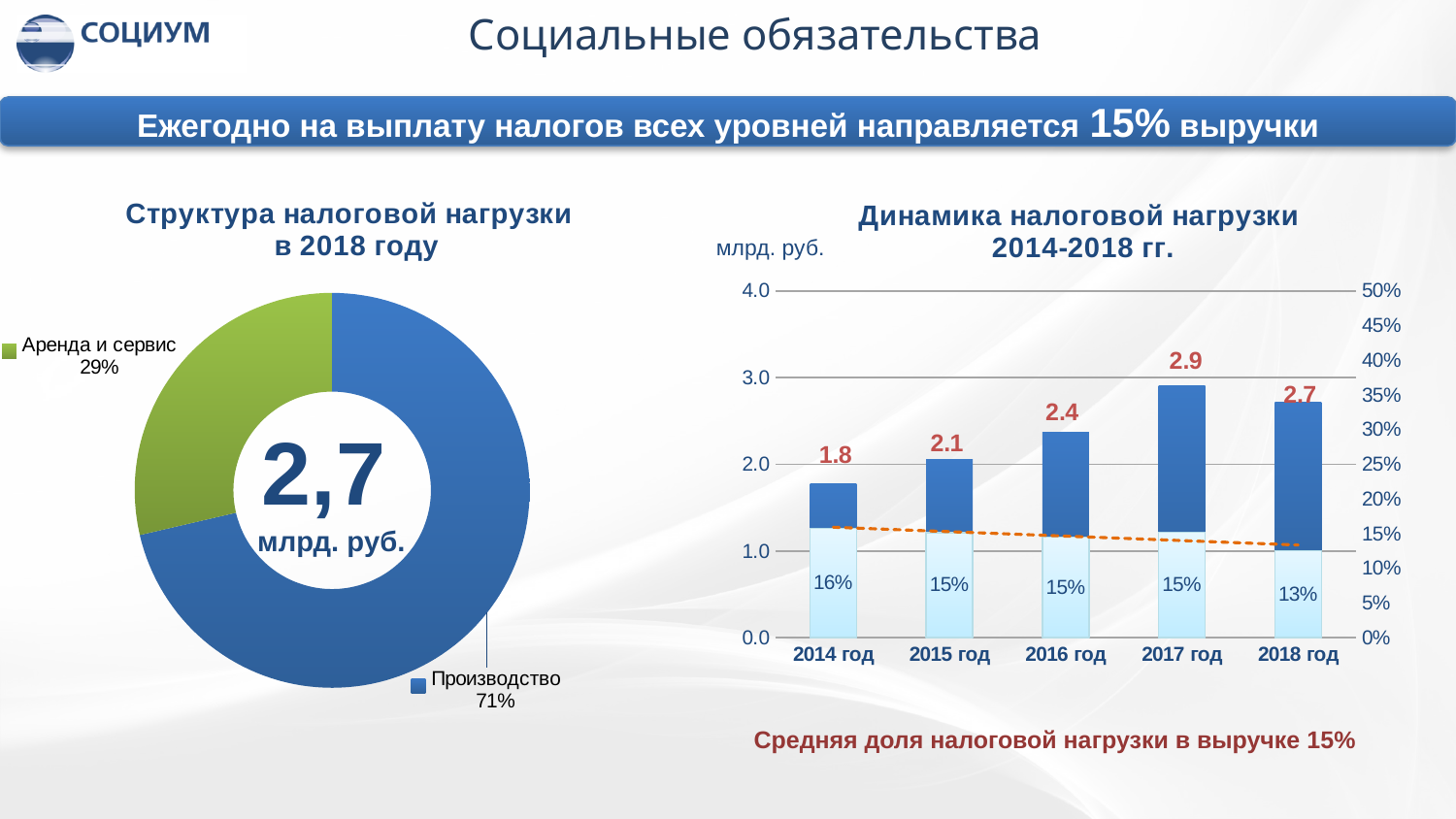
In the chart 'Динамика налоговой нагрузки 2014-2018 гг.', what is the value for 2016 год? 2.4 What kind of chart is 'Структура налоговой нагрузки в 2018 году'? Donut (pie) chart In the chart 'Структура налоговой нагрузки в 2018 году', what share does 'Производство' have? 71% In the chart 'Динамика налоговой нагрузки 2014-2018 гг.', what is the difference between the values for 2017 год and 2018 год? 0.2 In the chart 'Структура налоговой нагрузки в 2018 году', which category has the larger share? Производство In the chart 'Динамика налоговой нагрузки 2014-2018 гг.', what percentage is shown for 2018 год? 13% How many years are shown on the x axis of the chart 'Динамика налоговой нагрузки 2014-2018 гг.'? 5 What value is printed in the centre of the donut chart 'Структура налоговой нагрузки в 2018 году'? 2,7 млрд. руб. In the chart 'Динамика налоговой нагрузки 2014-2018 гг.', which year has the highest value? 2017 год In the chart 'Структура налоговой нагрузки в 2018 году', what share does 'Аренда и сервис' have? 29% In the chart 'Динамика налоговой нагрузки 2014-2018 гг.', which year has the lowest value? 2014 год In the chart 'Динамика налоговой нагрузки 2014-2018 гг.', what is the value for 2014 год? 1.8